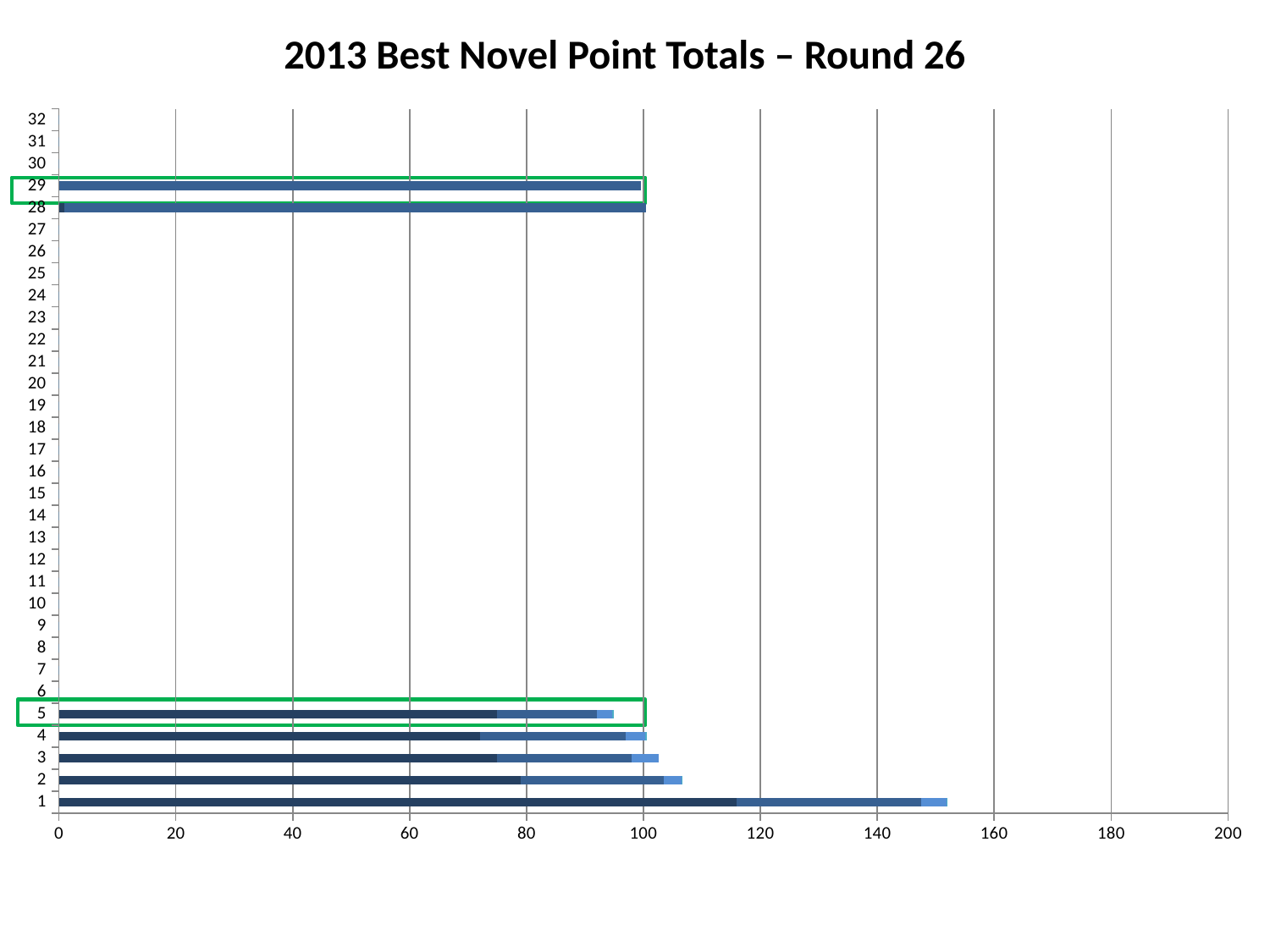
Is the total value for category 1 greater or less than 140? greater Which has the larger total, category 2 or category 5? 2 Which has the larger total, category 1 or category 2? 1 Is the total value for category 2 greater or less than 100? greater What kind of chart is shown on the slide? bar chart Which category has the longest bar? 1 Is the total value for category 5 greater or less than 100? less What is the title of the chart? 2013 Best Novel Point Totals – Round 26 How many categories have a visible bar plotted? 7 How many categories are labelled on the vertical axis? 32 What is the highest value shown on the horizontal axis? 200